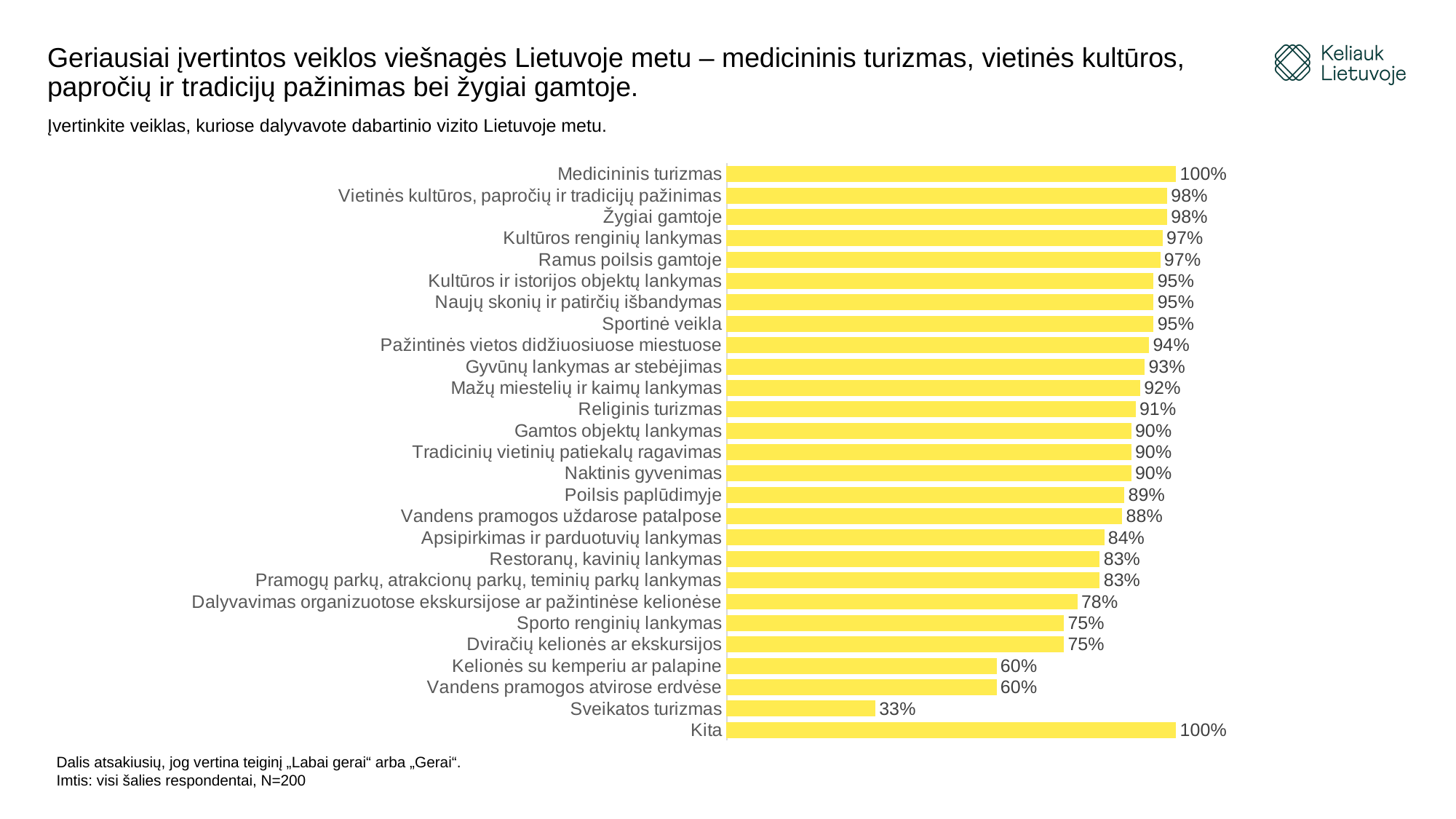
What is the difference between the values for Apsipirkimas ir parduotuvių lankymas and Sporto renginių lankymas? 9% How many categories are shown in the chart? 27 What is the value for Kelionės su kemperiu ar palapine? 60% What kind of chart is shown on the slide? bar chart What is the value for Medicininis turizmas? 100% What is the value for Dalyvavimas organizuotose ekskursijose ar pažintinėse kelionėse? 78% What is the value for Sveikatos turizmas? 33% Which is larger: the value for Vandens pramogos atvirose erdvėse or the value for Dviračių kelionės ar ekskursijos? Dviračių kelionės ar ekskursijos What colour are the bars in the chart? yellow Which category has the lowest value? Sveikatos turizmas What is the difference between the values for Medicininis turizmas and Sveikatos turizmas? 67% Which is larger: the value for Religinis turizmas or the value for Poilsis paplūdimyje? Religinis turizmas